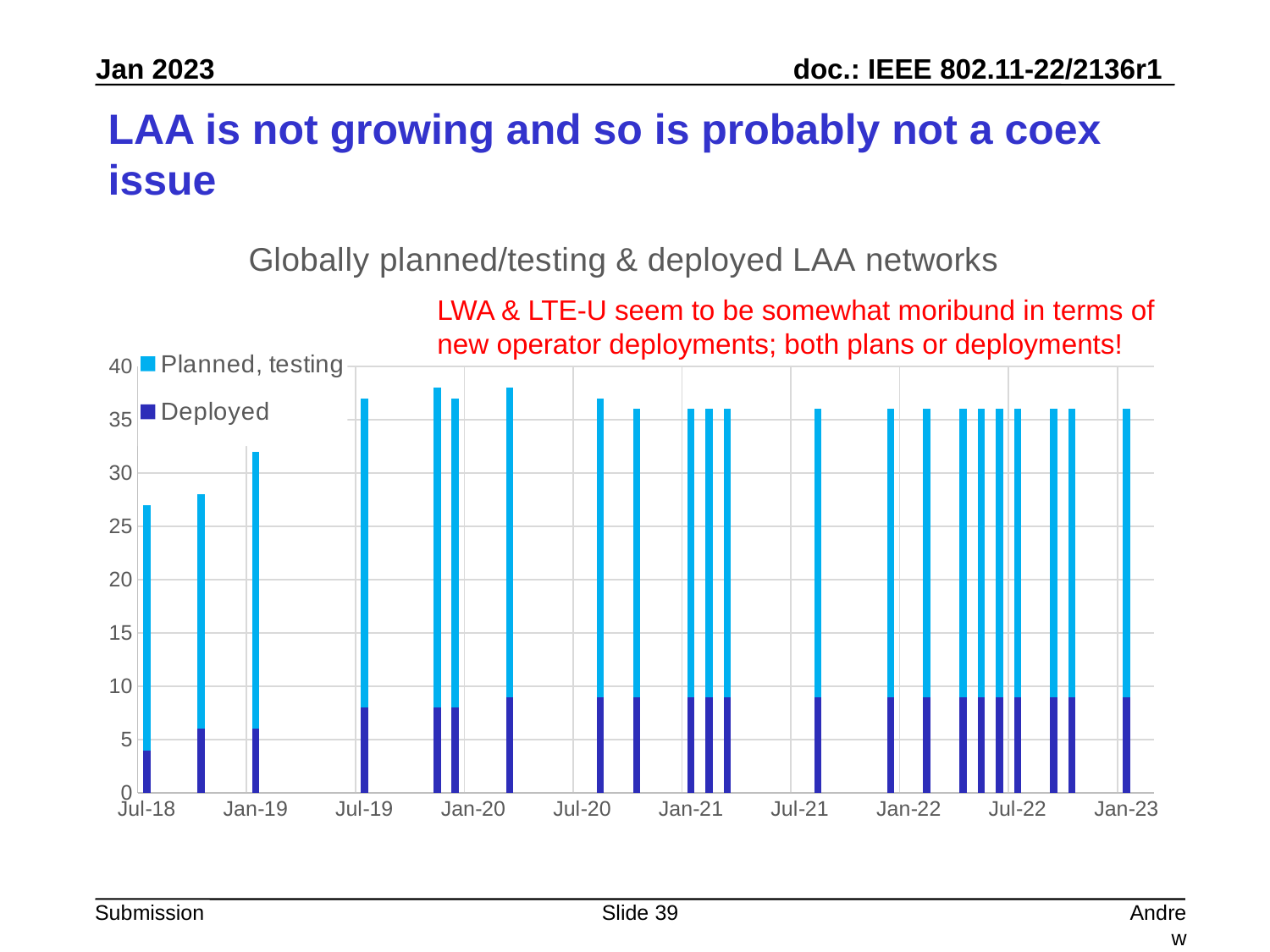
Is the Deployed value at Jan-23 greater or less than 5? greater Is the total height of the bar at Jan-23 greater or less than 30? greater Is the total height of the bar at Jul-19 greater or less than 35? greater How many series does the chart legend list? 2 What kind of chart is shown on the slide? Stacked bar chart Do the total bar heights rise or fall from Jul-18 to Jul-19? rise What is the title of the chart? Globally planned/testing & deployed LAA networks Which series is shown in dark blue in the chart? Deployed Which date has the lowest total bar in the chart? Jul-18 Which bar has the lowest total, the one at Jul-18 or the one at Jan-23? Jul-18